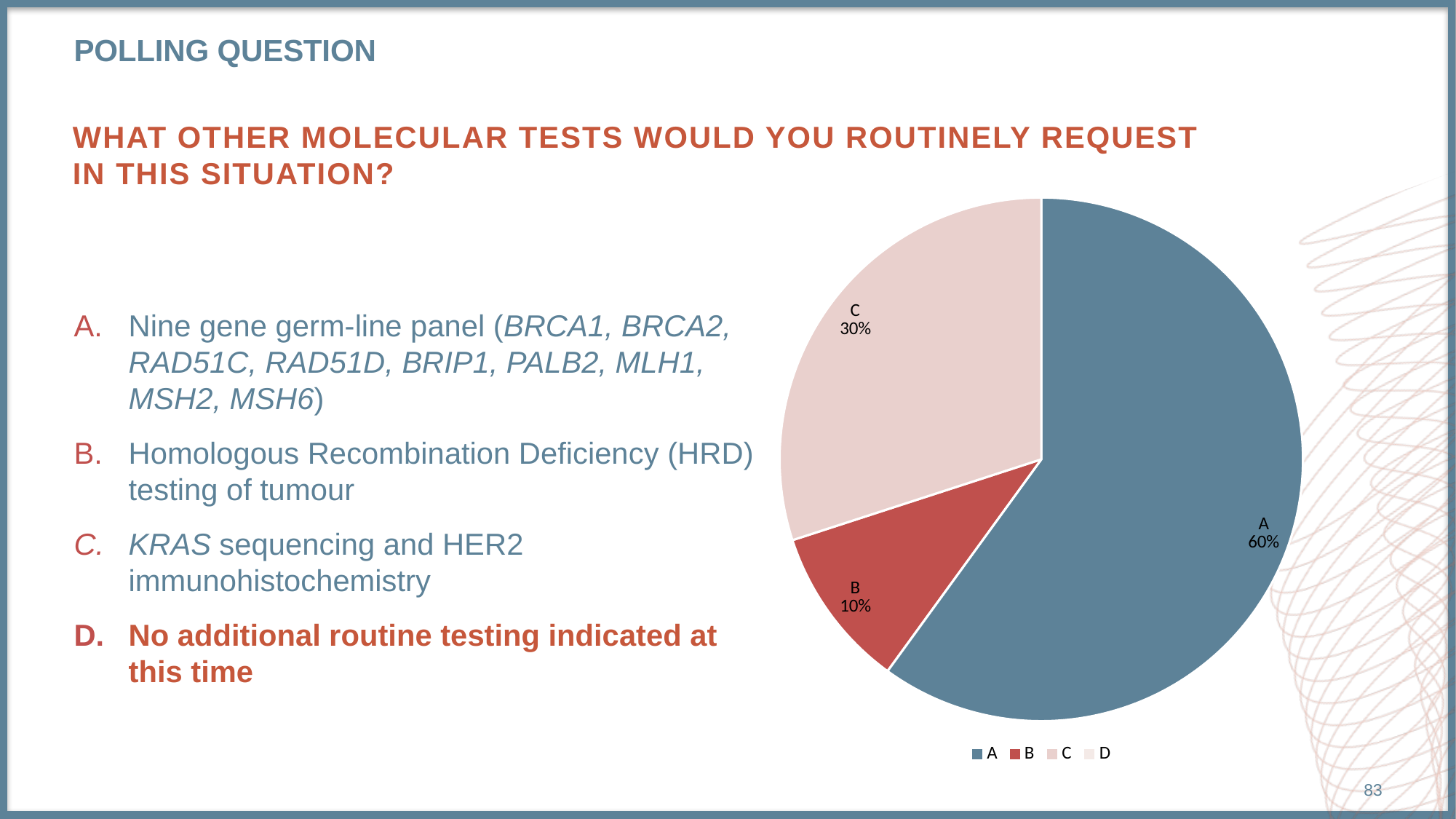
Which slice of the pie chart is the largest? A What is the difference in percentage points between slice A and slice C? 30 Which labelled slice of the pie chart is the smallest? B What is the difference in percentage points between slice C and slice B? 20 Which slice is larger, B or C? C What kind of chart is shown on the slide? Pie chart What colour is slice B in the pie chart? Red What percentage of the pie chart is labelled for slice C? 30% What percentage of the pie chart is labelled for slice A? 60% What share of the pie does slice A represent? 60% How many entries does the chart legend list? 4 What percentage of the pie chart is labelled for slice B? 10%